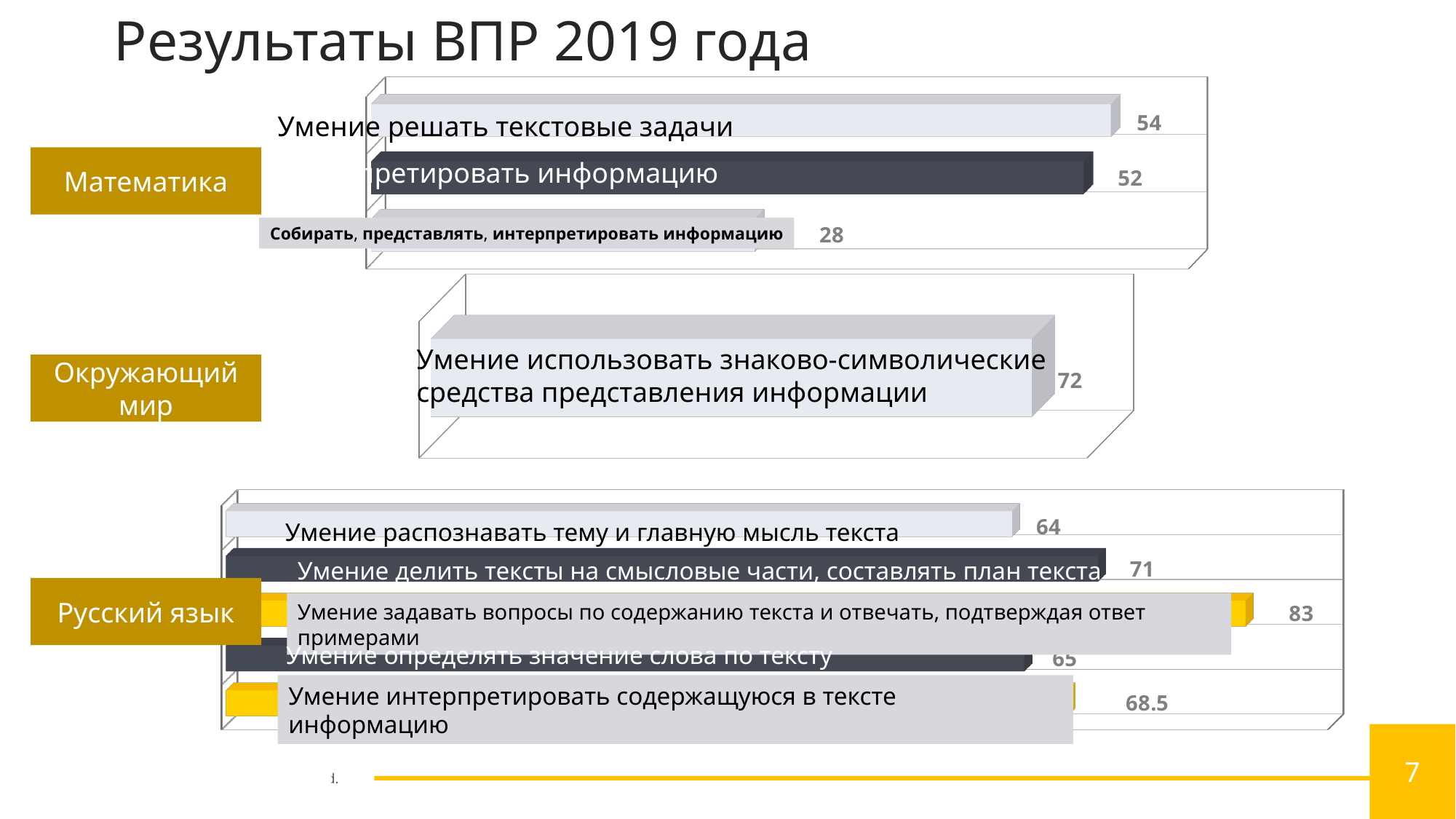
In the Русский язык chart, what is the value for "Умение интерпретировать содержащуюся в тексте информацию"? 68.5 In the Русский язык chart, what is the value for "Умение задавать вопросы по содержанию текста и отвечать, подтверждая ответ примерами"? 83 In the Математика chart, which category has the lowest value? Собирать, представлять, интерпретировать информацию In the Русский язык chart, which category has the lowest value? Умение распознавать тему и главную мысль текста In the Математика chart, what is the value for "Собирать, представлять, интерпретировать информацию"? 28 In the Русский язык chart, which category has the highest value? Умение задавать вопросы по содержанию текста и отвечать, подтверждая ответ примерами How many bars does the Математика chart show? 3 In the Русский язык chart, which is larger: the value for "Умение делить тексты на смысловые части, составлять план текста" or for "Умение определять значение слова по тексту"? Умение делить тексты на смысловые части, составлять план текста In the Математика chart, what is the value for "Умение решать текстовые задачи"? 54 In the Математика chart, what is the difference between the values for "Умение решать текстовые задачи" and "Собирать, представлять, интерпретировать информацию"? 26 What type of chart is the Русский язык chart? Bar chart In the Окружающий мир chart, what is the value for "Умение использовать знаково-символические средства представления информации"? 72